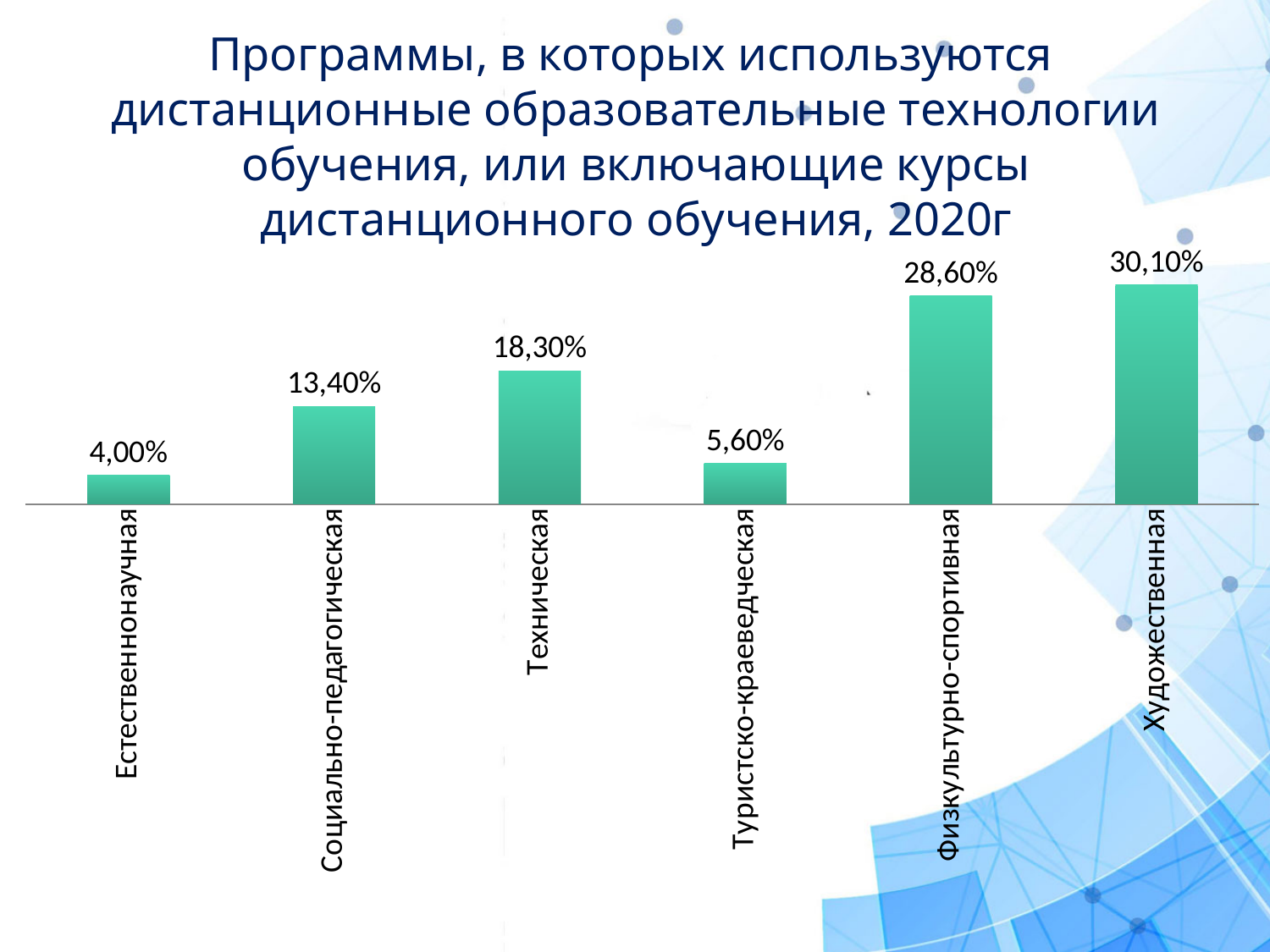
Which category has the highest value? Художественная What year is mentioned in the chart title? 2020 What is the value for Художественная? 30,10% How many categories are shown in the chart? 6 Which category has the lowest value? Естественнонаучная What kind of chart is shown on the slide? Bar chart What is the value for Туристско-краеведческая? 5,60% What is the difference between the values for Техническая and Социально-педагогическая? 4,90% What is the value for Техническая? 18,30% What is the value for Социально-педагогическая? 13,40% What is the difference between the values for Художественная and Физкультурно-спортивная? 1,50% Which is larger, the value for Техническая or the value for Туристско-краеведческая? Техническая